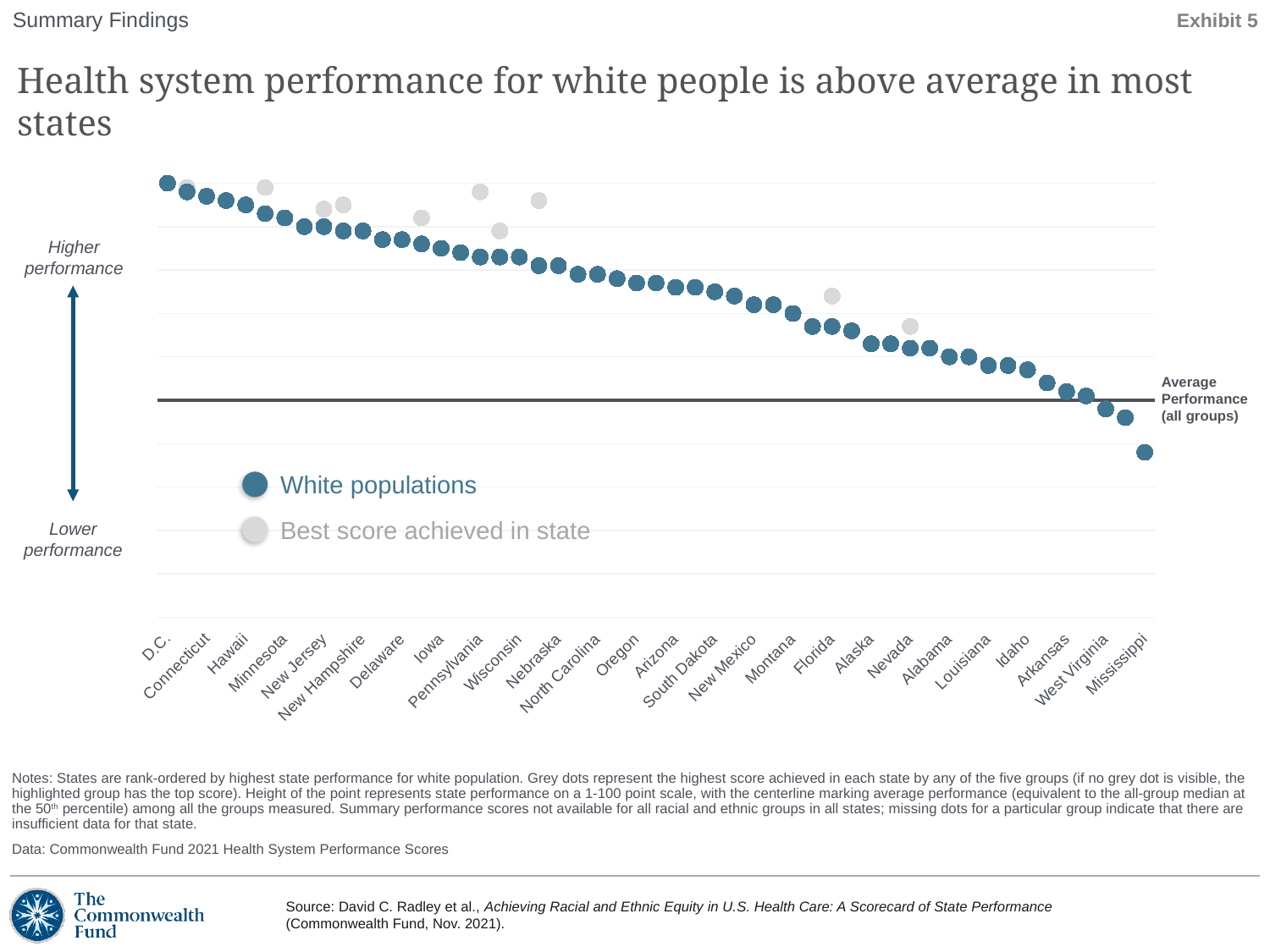
Which state has the lowest white population performance score? Mississippi Which has a higher white population score, Florida or Arkansas? Florida Which has a higher white population score, Connecticut or Mississippi? Connecticut What does the horizontal line across the chart represent? Average Performance (all groups) Which state or jurisdiction has the highest white population performance score? D.C. What are the two series named in the legend? White populations; Best score achieved in state Do the white population scores rise or fall moving from left to right along the x axis? Fall How many series does the legend list? 2 Which has a higher white population score, Hawaii or Idaho? Hawaii What kind of chart is shown on the slide? Dot plot (scatter chart)